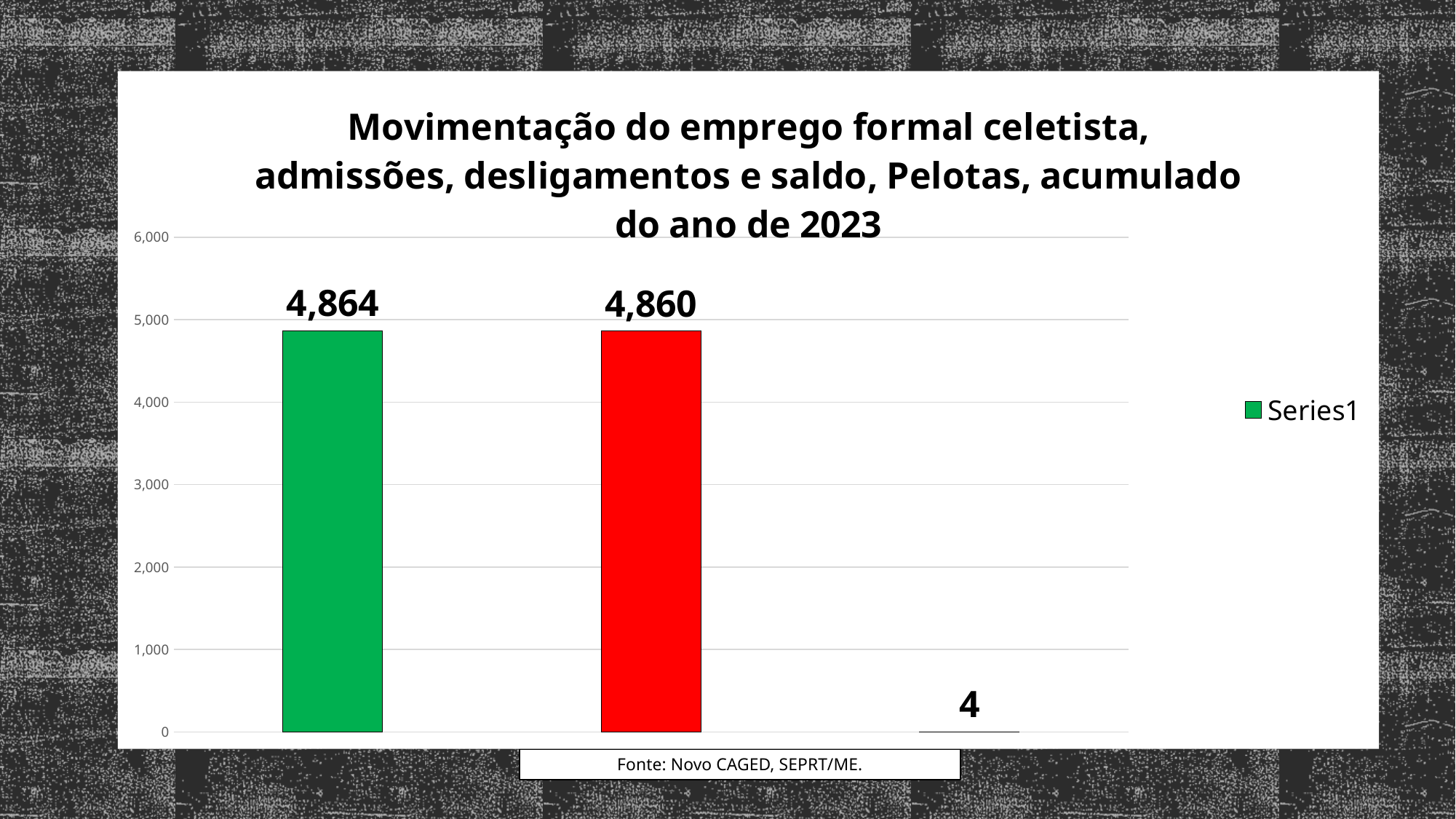
What is the value shown for the third (rightmost) bar? 4 What is the name of the series shown in the legend? Series1 How many bars are plotted in the chart? 3 What is the difference between the green bar's value and the red bar's value? 4 Which is larger, the value of the green bar or the value of the red bar? The green bar (4,864) What is the value shown on the red bar? 4,860 How many series does the legend list? 1 Which bar has the lowest value? The third (rightmost) bar, with 4 What is the highest value shown on the vertical axis? 6,000 Is the value of the red bar greater or less than 5,000? less What is the value shown on the green bar? 4,864 What kind of chart is shown on the slide? Bar chart